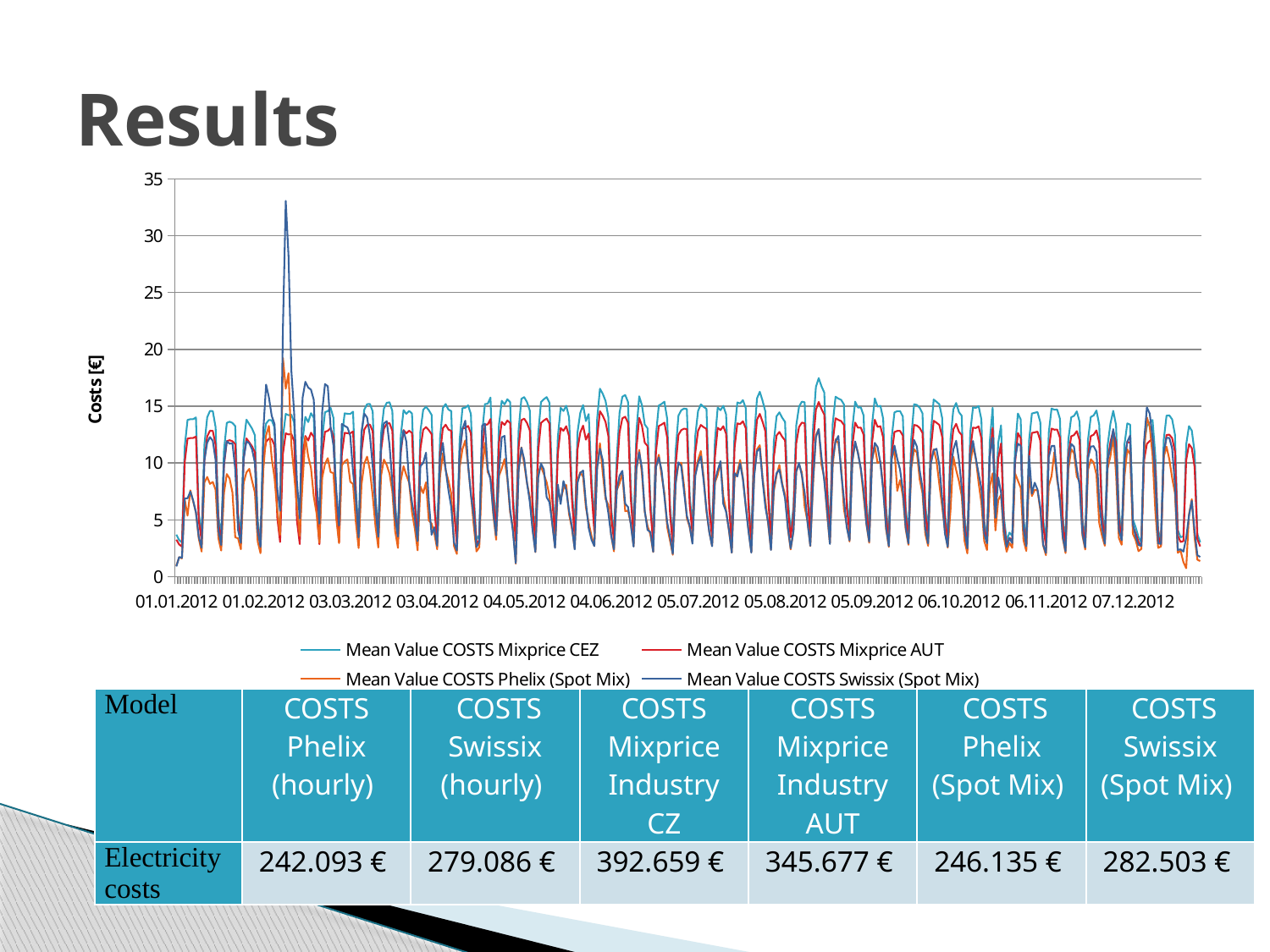
Which series reaches the highest peak in the chart? Mean Value COSTS Swissix (Spot Mix) Is the highest value of Mean Value COSTS Mixprice CEZ greater or less than 20? less What type of chart is shown on the slide? line chart What is the first date label on the x axis of the chart? 01.01.2012 What colour is the line for Mean Value COSTS Mixprice AUT in the chart? red What is the last date label on the x axis of the chart? 07.12.2012 What is the label of the vertical axis of the chart? Costs [€] How many series does the chart legend list? 4 How many date labels are shown along the x axis of the chart? 12 Is the highest peak of Mean Value COSTS Swissix (Spot Mix) greater or less than 30? greater What is the maximum value shown on the vertical axis of the chart? 35 Is the lowest value of Mean Value COSTS Phelix (Spot Mix) greater or less than 5? less